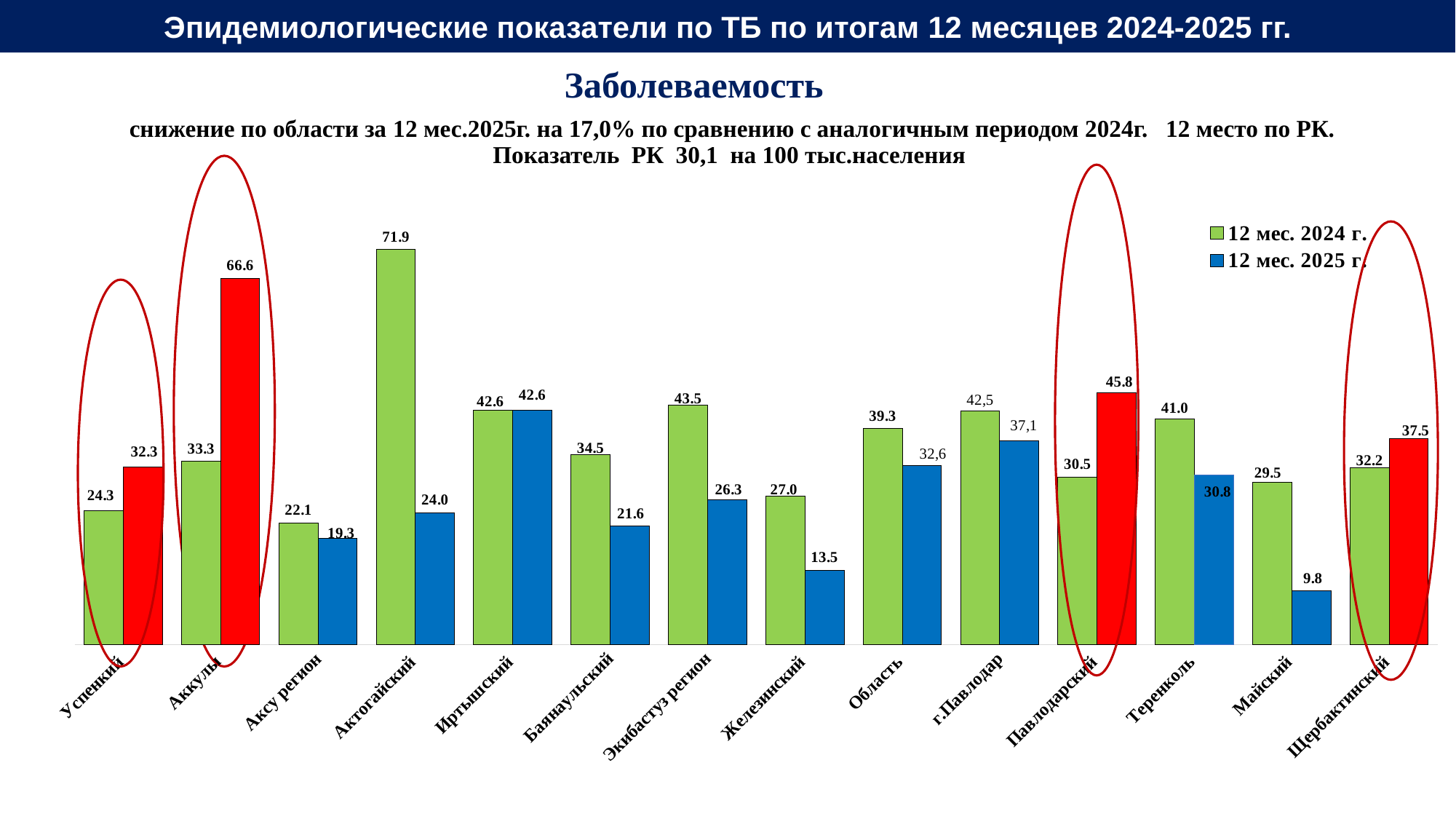
How many categories are shown on the x axis? 14 How many series does the legend list? 2 What is the value for Актогайский in the 12 мес. 2024 г. series? 71.9 What kind of chart is shown on the slide? bar chart What is the difference between the 12 мес. 2024 г. and 12 мес. 2025 г. values for Актогайский? 47.9 Which category has the highest value in the 12 мес. 2025 г. series? Аккулы Which category has the highest value in the 12 мес. 2024 г. series? Актогайский What is the value for Майский in the 12 мес. 2025 г. series? 9.8 What is the value for Область in the 12 мес. 2024 г. series? 39.3 Which category has the lowest value in the 12 мес. 2025 г. series? Майский What is the value for Аккулы in the 12 мес. 2025 г. series? 66.6 Which is larger for Павлодарский: the 12 мес. 2024 г. value or the 12 мес. 2025 г. value? 12 мес. 2025 г.